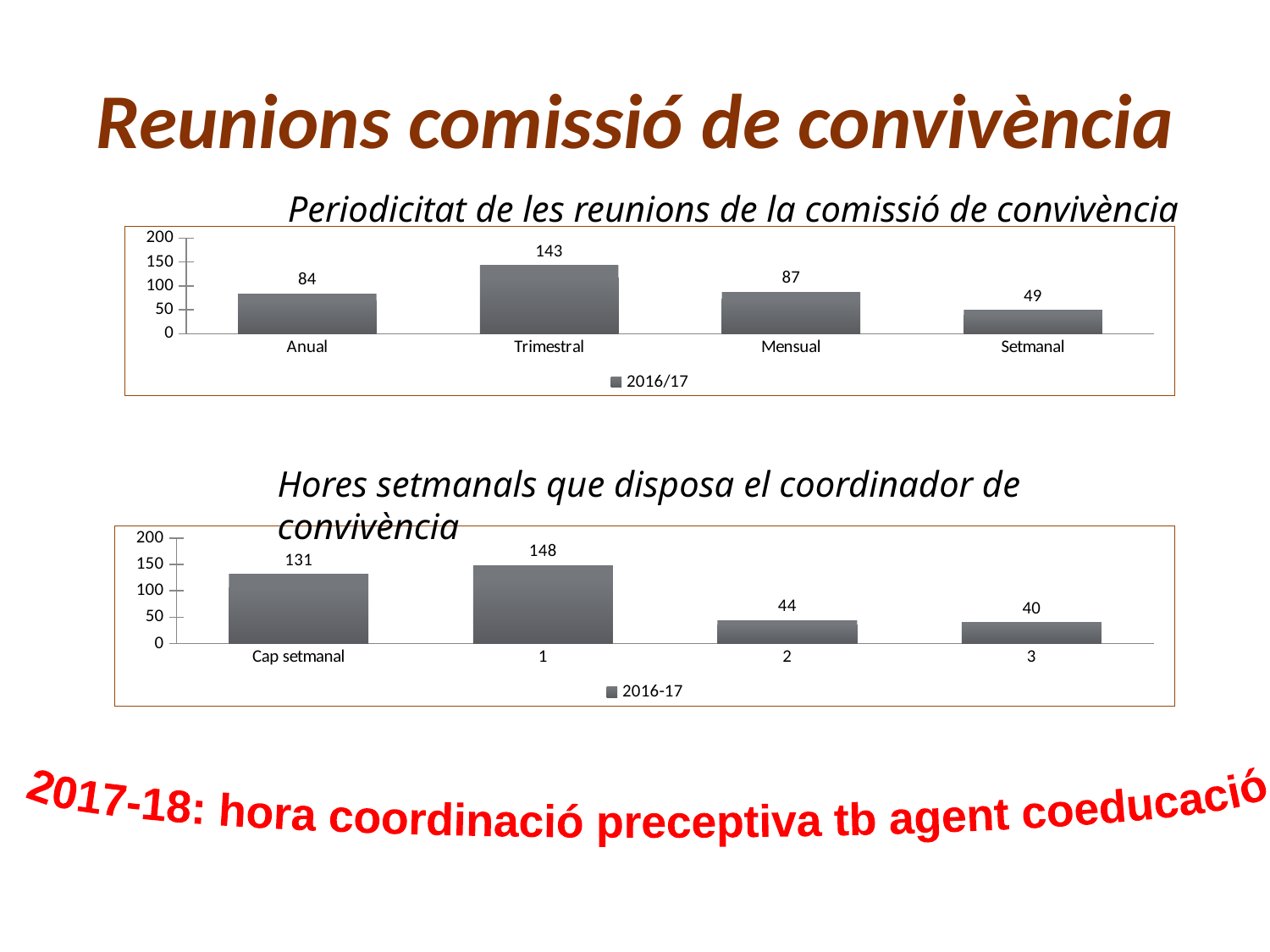
In the bottom chart 'Hores setmanals que disposa el coordinador de convivència', what kind of chart is shown? Bar chart In the top chart 'Periodicitat de les reunions de la comissió de convivència', what is the value for Trimestral? 143 In the top chart 'Periodicitat de les reunions de la comissió de convivència', how many categories are shown on the x axis? 4 In the bottom chart 'Hores setmanals que disposa el coordinador de convivència', what series name does the legend show? 2016-17 In the top chart 'Periodicitat de les reunions de la comissió de convivència', which category has the lowest value? Setmanal In the bottom chart 'Hores setmanals que disposa el coordinador de convivència', what is the value for category 2? 44 In the bottom chart 'Hores setmanals que disposa el coordinador de convivència', what is the value for Cap setmanal? 131 In the top chart 'Periodicitat de les reunions de la comissió de convivència', which category has the highest value? Trimestral In the top chart 'Periodicitat de les reunions de la comissió de convivència', what is the value for Setmanal? 49 In the bottom chart 'Hores setmanals que disposa el coordinador de convivència', which category has the highest value? 1 In the bottom chart 'Hores setmanals que disposa el coordinador de convivència', what is the difference between the values for category 1 and category 3? 108 In the top chart 'Periodicitat de les reunions de la comissió de convivència', what is the difference between the values for Trimestral and Anual? 59